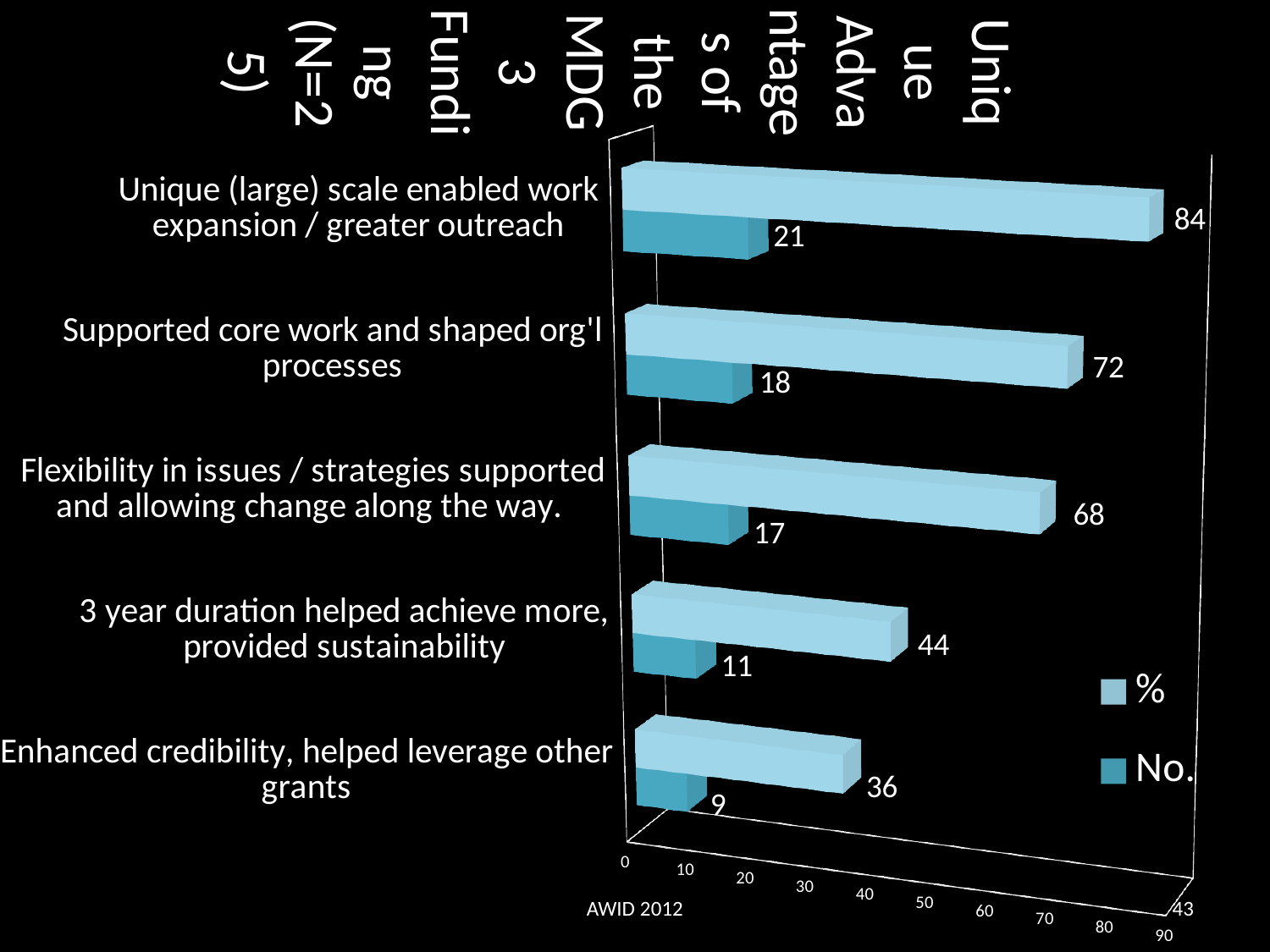
Which is larger: the No. value for "Flexibility in issues / strategies supported and allowing change along the way." or the No. value for "3 year duration helped achieve more, provided sustainability"? Flexibility in issues / strategies supported and allowing change along the way. Which category has the highest % value? Unique (large) scale enabled work expansion / greater outreach What is the difference between the % values for "Supported core work and shaped org'l processes" and "Flexibility in issues / strategies supported and allowing change along the way."? 4 What is the No. value for "Enhanced credibility, helped leverage other grants"? 9 How many categories are shown in the chart? 5 What is the No. value for "Supported core work and shaped org'l processes"? 18 Which category has the lowest No. value? Enhanced credibility, helped leverage other grants How many series does the legend list? 2 What are the two series named in the legend? % and No. What is the % value for "3 year duration helped achieve more, provided sustainability"? 44 What kind of chart is shown on the slide? Bar chart What is the % value for "Unique (large) scale enabled work expansion / greater outreach"? 84